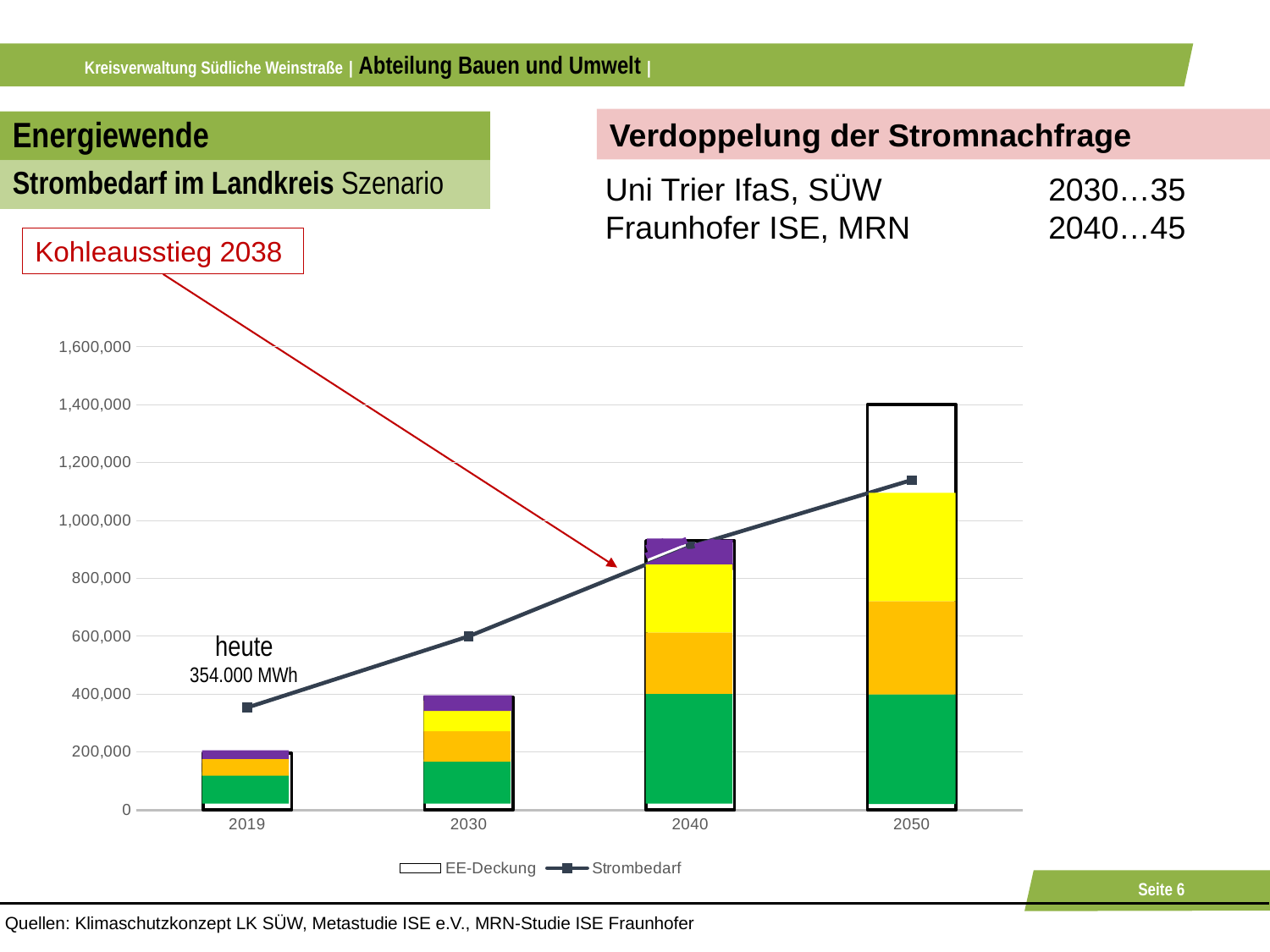
Does the Strombedarf line rise or fall from 2019 to 2050? Rises Is the Strombedarf value for 2030 greater or less than 800,000? less How many years are shown on the x axis of the chart? 4 How many series does the chart legend list? 2 What are the two entries listed in the chart legend? EE-Deckung and Strombedarf Is the EE-Deckung value for 2019 greater or less than 400,000? less Is the EE-Deckung value for 2050 greater or less than 1,200,000? greater What is the Strombedarf value shown for 2019 on the chart? 354.000 MWh Which year has the larger EE-Deckung bar, 2019 or 2040? 2040 In which year is the EE-Deckung bar the lowest? 2019 What kind of chart is shown on the slide? Combined stacked bar and line chart In which year is the EE-Deckung bar the highest? 2050